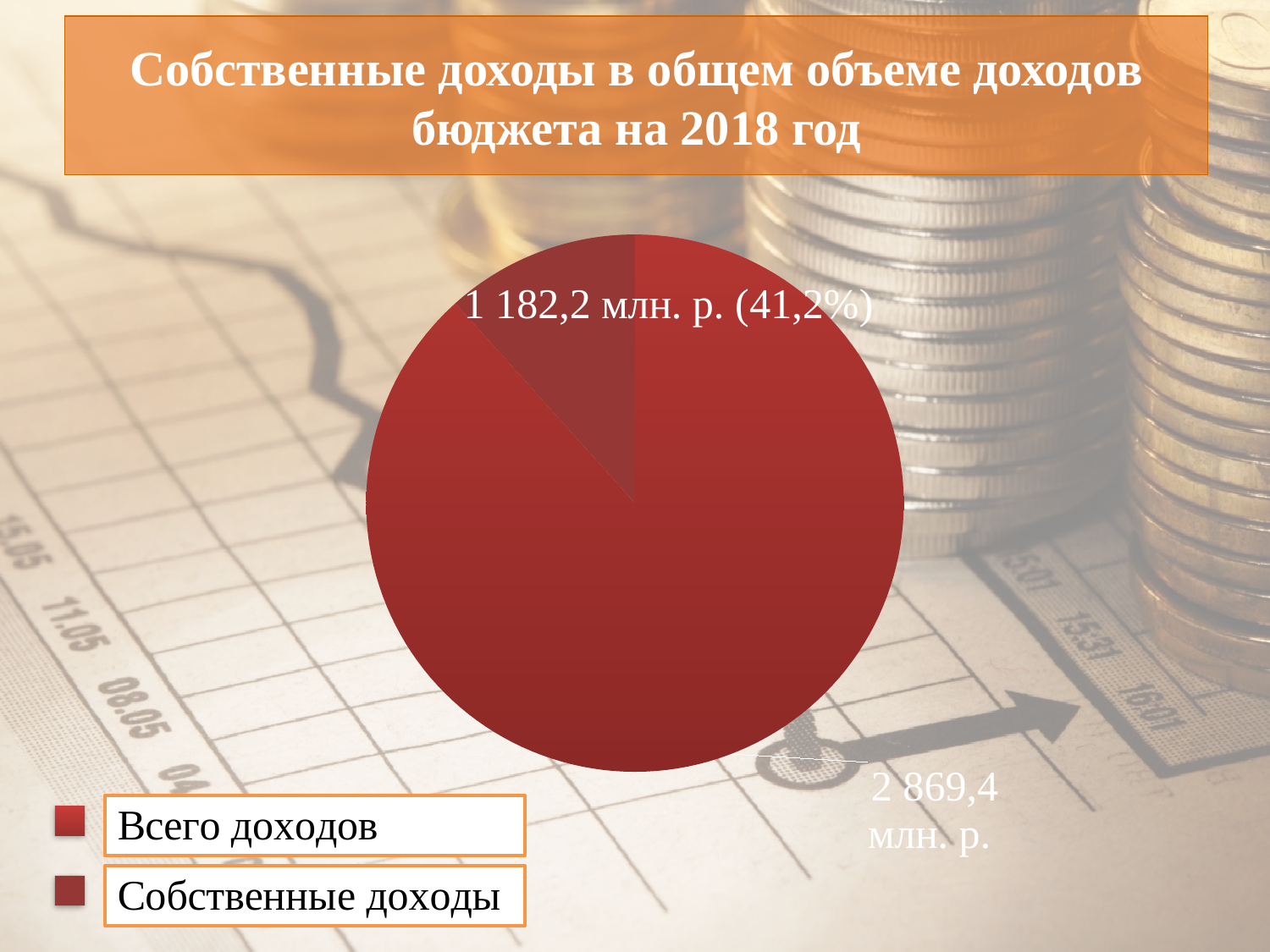
How many slices does the pie chart have? 2 Which is larger, Всего доходов or Собственные доходы? Всего доходов Which legend entry is shown in the darker red colour? Собственные доходы Which slice of the pie is the smallest? Собственные доходы What percentage share is printed for Собственные доходы? 41,2% What value is shown for Всего доходов? 2 869,4 млн. р. What is the difference between Всего доходов and Собственные доходы? 1 687,2 млн. р. What is the title of the chart on the slide? Собственные доходы в общем объеме доходов бюджета на 2018 год Which slice of the pie is the largest? Всего доходов What value is shown for Собственные доходы? 1 182,2 млн. р. What kind of chart is shown on the slide? pie chart How many entries does the legend list? 2